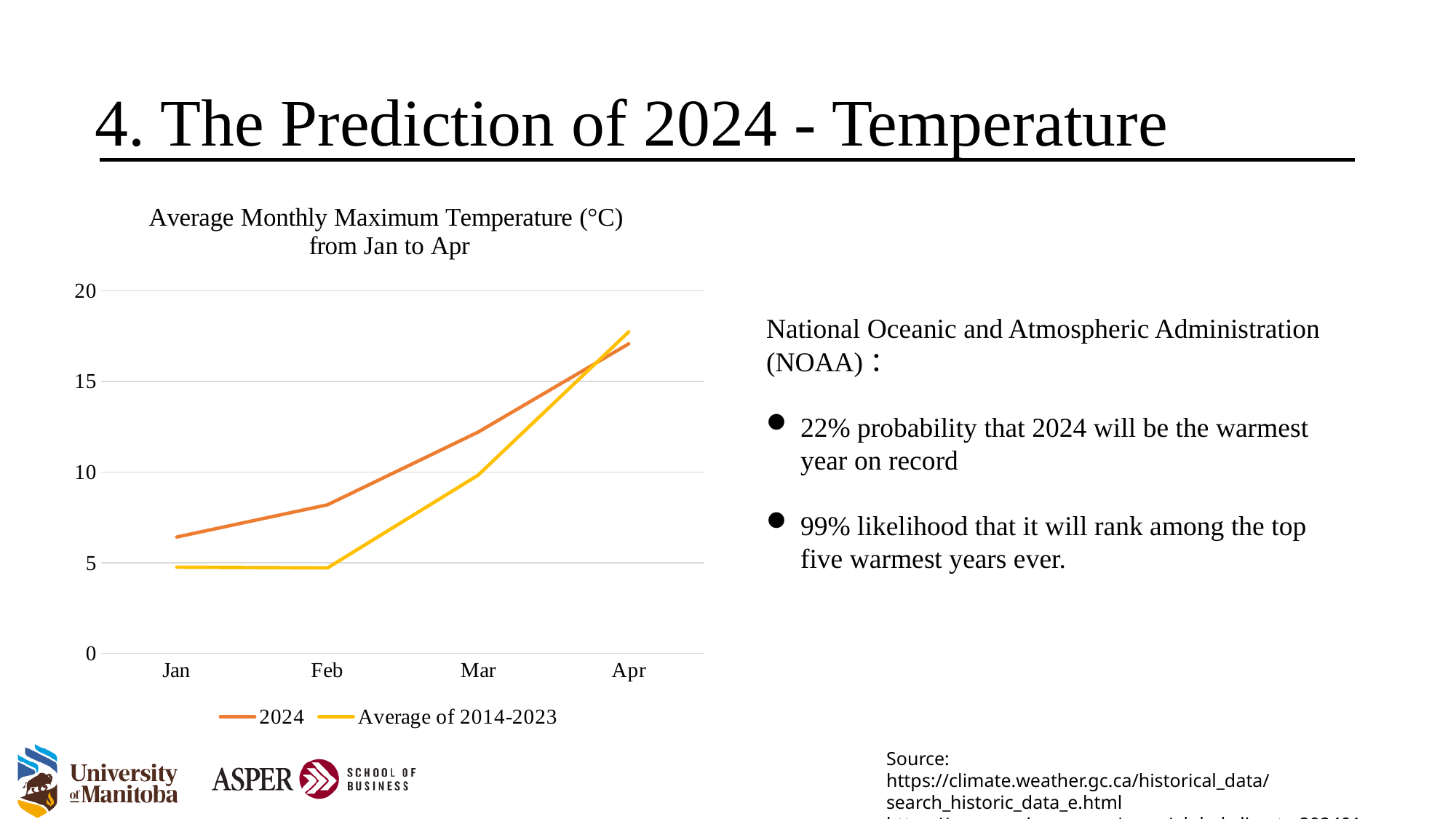
What is the title of the chart? Average Monthly Maximum Temperature (°C) from Jan to Apr How many series does the chart legend list? 2 Is the 2024 value for Feb greater or less than 10? less Is the Average of 2014-2023 value for Apr greater or less than 15? greater Is the 2024 value for Jan greater or less than 5? greater Which month has the highest value for the 2024 series? Apr What kind of chart is shown on the slide? line chart How many months are plotted along the x axis of the chart? 4 Do the values of the 2024 series rise or fall from Jan to Apr? rise Which month has the lowest value for the 2024 series? Jan In Mar, which series has the larger value, 2024 or Average of 2014-2023? 2024